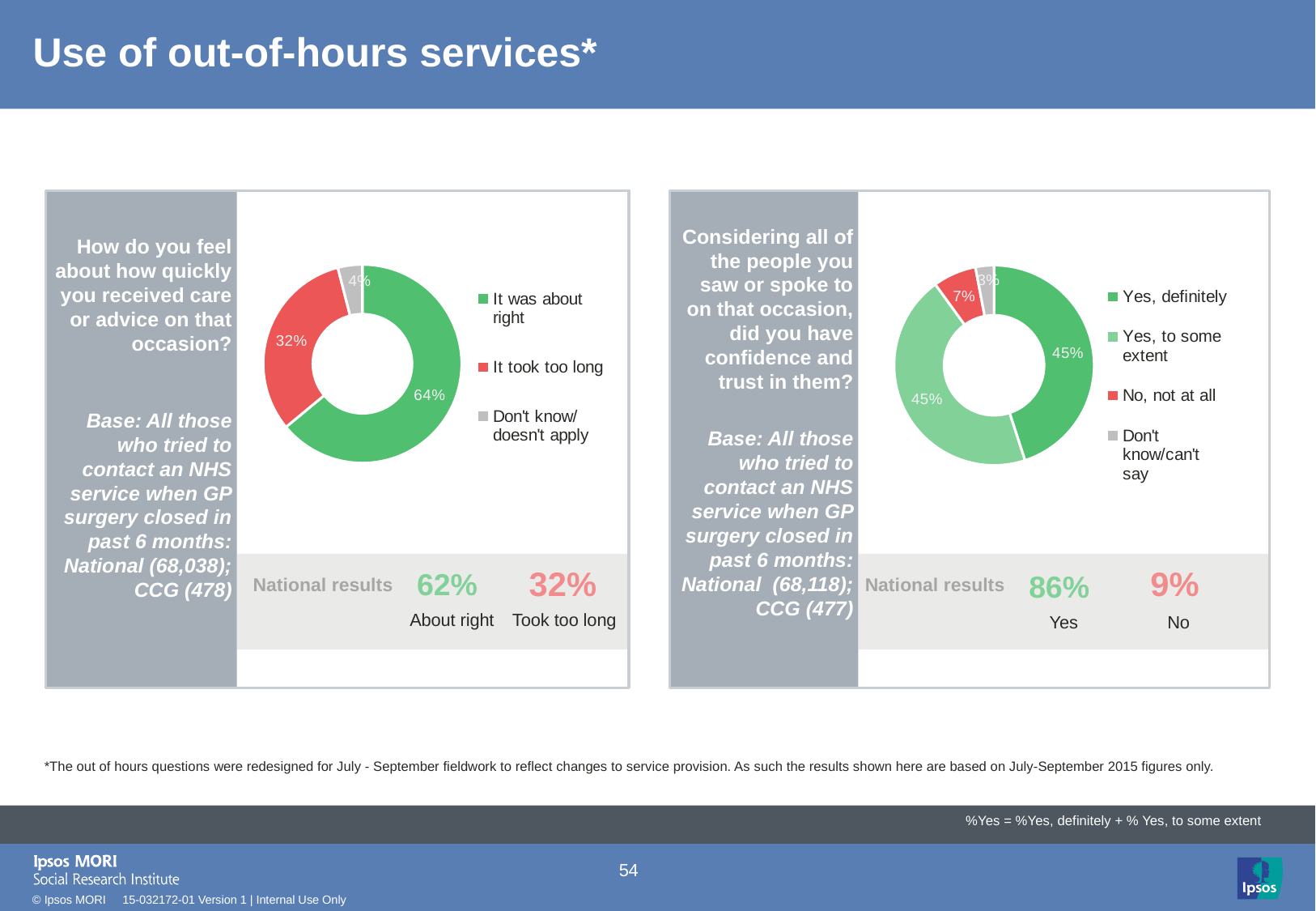
In the left chart (how quickly you received care or advice), which response has the smallest share? Don't know/doesn't apply In the right chart (confidence and trust), which is larger: 'Yes, to some extent' or 'No, not at all'? Yes, to some extent In the right chart (confidence and trust), what percentage said 'Yes, definitely'? 45% In the right chart (confidence and trust), what percentage said 'No, not at all'? 7% How many categories does the legend of the left chart (how quickly you received care or advice) list? 3 In the left chart (how quickly you received care or advice), what percentage said it took too long? 32% How many categories does the legend of the right chart (confidence and trust) list? 4 What type of chart is used on this slide to show the responses? Pie (donut) chart In the right chart (confidence and trust), which response has the smallest share? Don't know/can't say In the left chart (how quickly you received care or advice), what is the difference in percentage points between 'It was about right' and 'It took too long'? 32 In the left chart (how quickly you received care or advice), what percentage said it was about right? 64% In the left chart (how quickly you received care or advice), which response has the largest share? It was about right